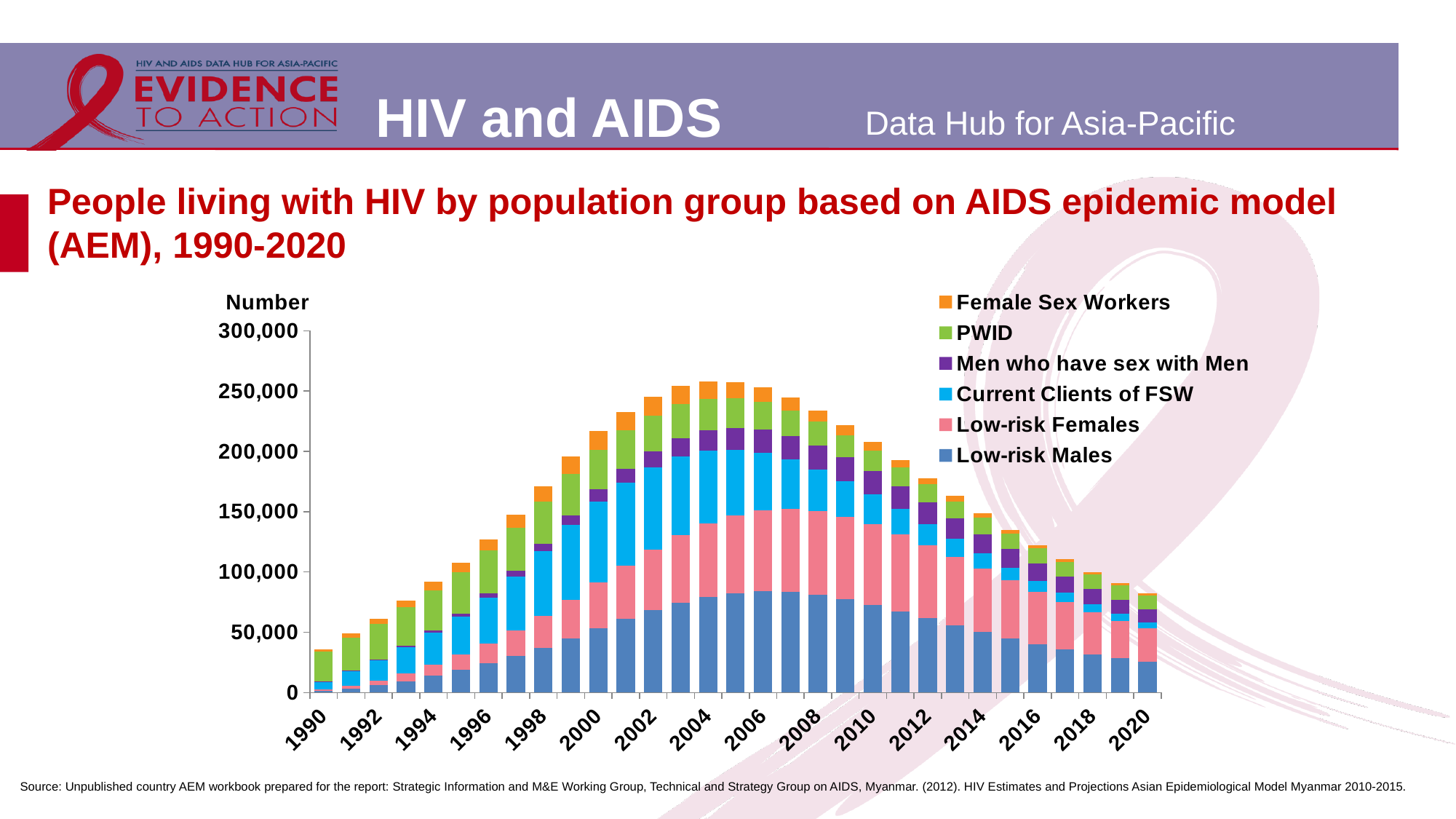
Is the total for 1990 greater or less than 50,000? less Is the total for 2004 greater or less than 250,000? greater Which year has the lowest total number of people living with HIV? 1990 What colour represents PWID in the legend? Green What kind of chart is shown on the slide? Stacked bar chart Is the total for 2000 greater or less than 200,000? greater How many years (bars) are plotted on the x axis? 31 How many series does the legend list? 6 Which year has the larger total, 2000 or 2014? 2000 Which population group is shown at the bottom of each stacked bar? Low-risk Males Do the total values rise or fall from 2006 to 2020? Fall